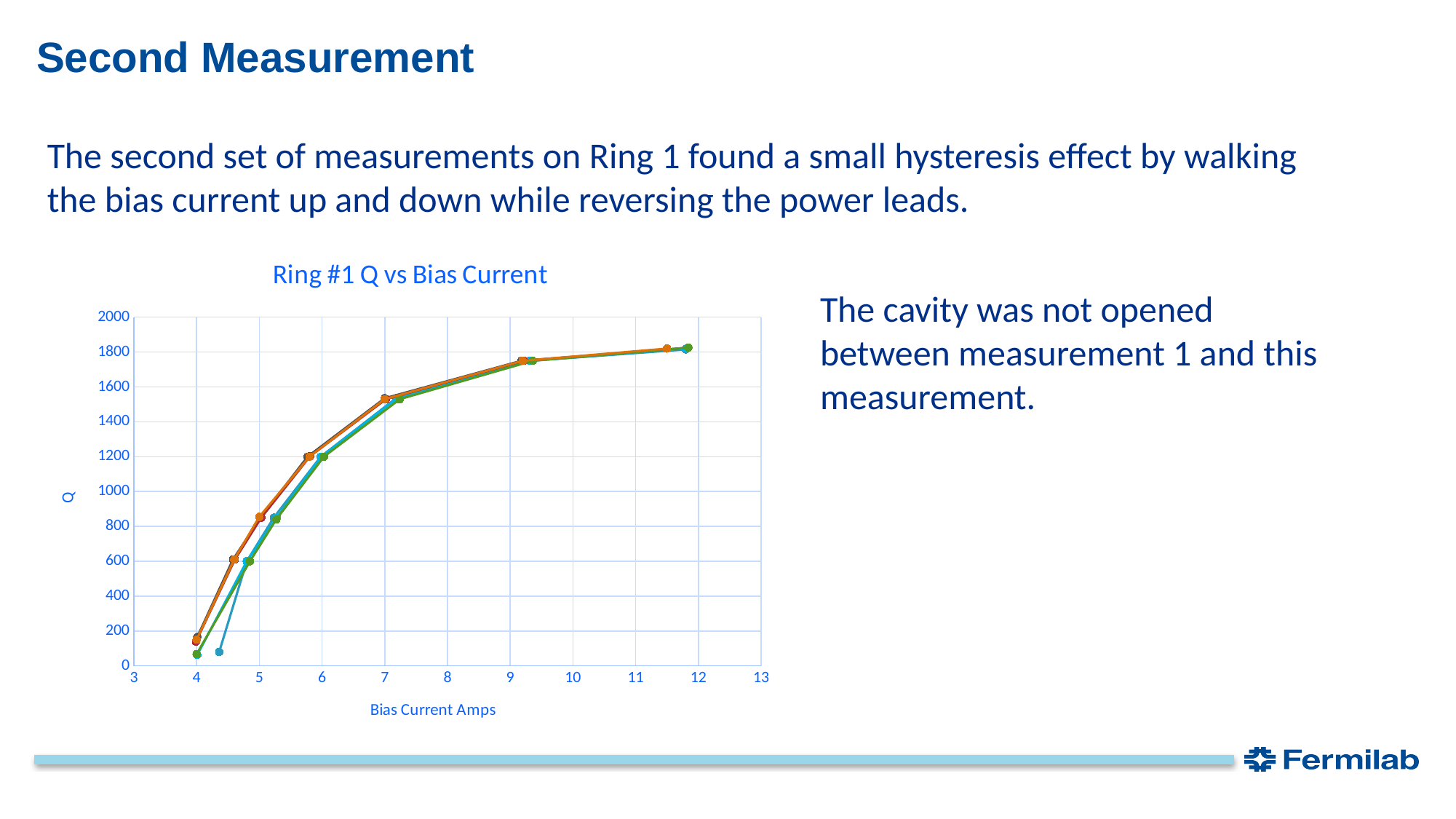
What is the label of the x axis of the chart? Bias Current Amps Is the Q value at a bias current of about 4 amps greater or less than 400? less Do the Q values rise or fall as the bias current increases along the x axis? rise What kind of chart is shown on the slide? line chart What is the title of the chart? Ring #1 Q vs Bias Current Is the Q value at a bias current of about 9 amps greater or less than 1600? greater Is the Q value at a bias current of about 7 amps greater or less than 1400? greater